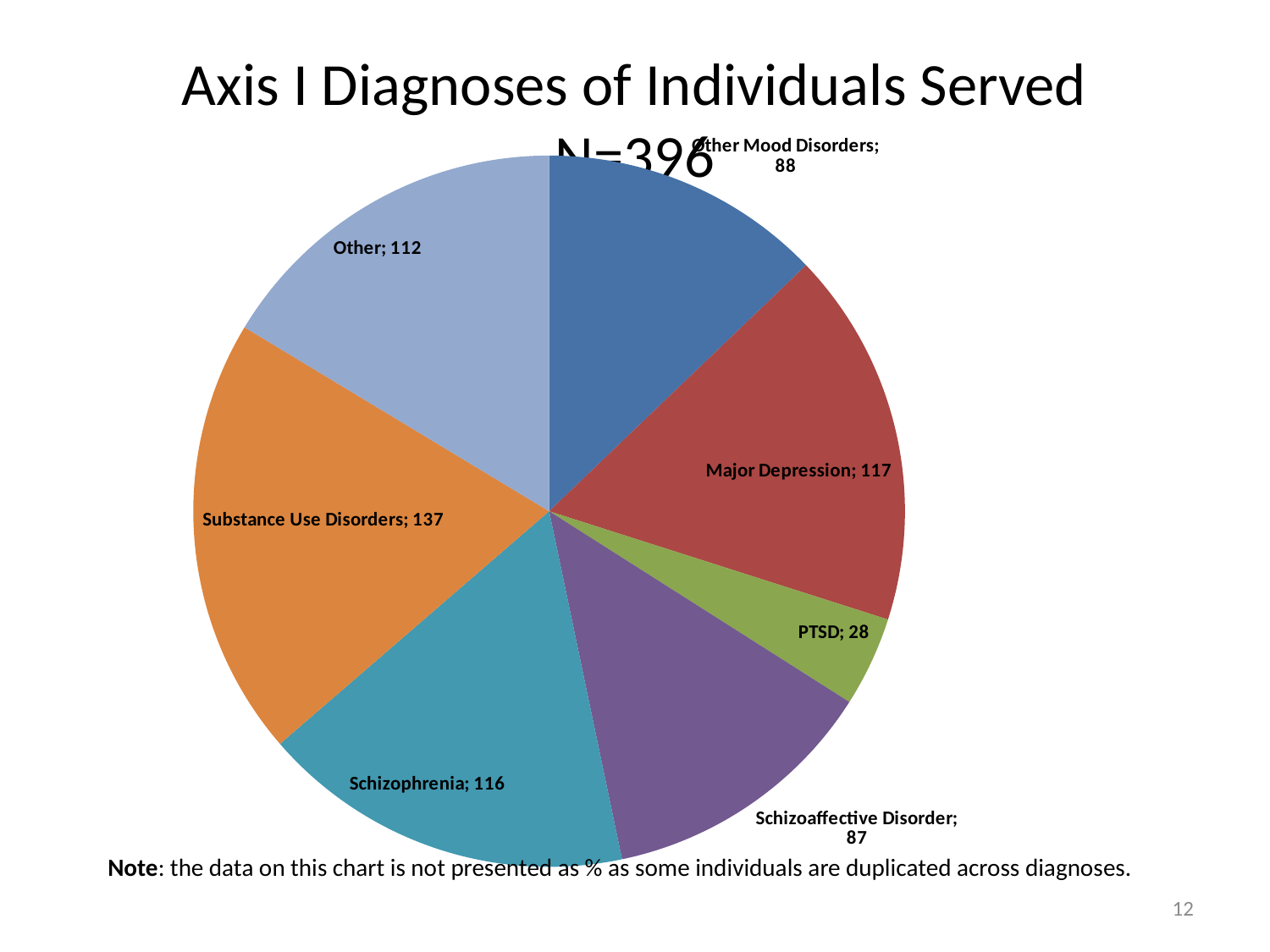
What value is shown for Schizoaffective Disorder? 87 What is the difference between the values for Substance Use Disorders and Other? 25 What is the difference between the values for Major Depression and Schizophrenia? 1 Which is larger, the value for Other Mood Disorders or the value for Schizoaffective Disorder? Other Mood Disorders What value is shown for Substance Use Disorders? 137 What type of chart is shown on the slide? pie chart What value is shown for Major Depression? 117 Which diagnosis has the smallest slice of the pie? PTSD Which diagnosis has the largest slice of the pie? Substance Use Disorders What N value is stated in the chart title? N=396 What value is shown for PTSD? 28 How many diagnosis categories are shown in the pie chart? 7